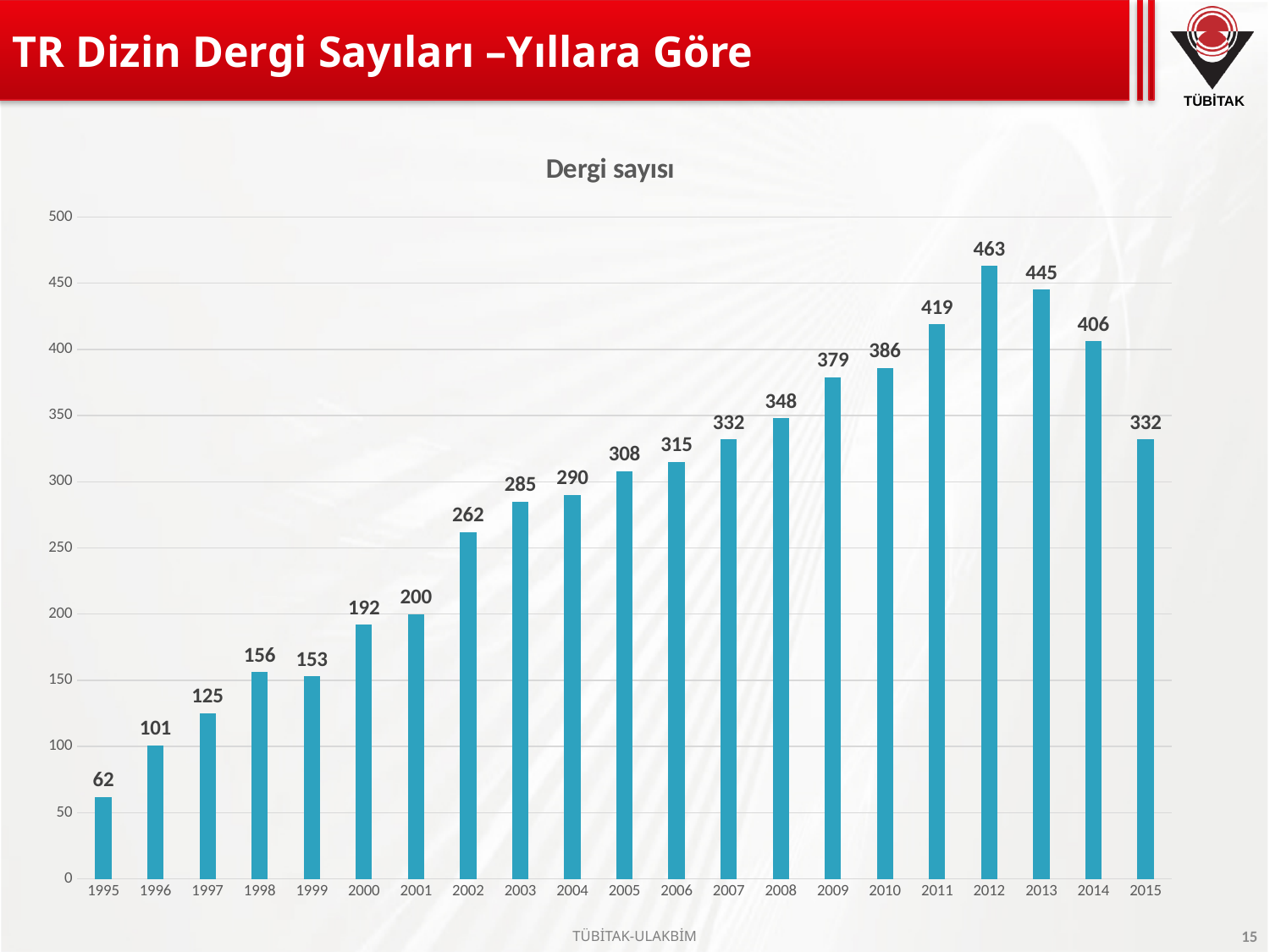
What is the value for 1995? 62 What is the difference between the values for 2012 and 2013? 18 Which year has the lowest value? 1995 What is the value for 2015? 332 Which is larger, the value for 1998 or the value for 1999? 1998 Is the value for 2009 greater or less than 350? greater What is the value for 2012? 463 What is the title of the chart? Dergi sayısı Which year has the highest value? 2012 How many years are shown on the x axis? 21 What is the difference between the values for 2014 and 2015? 74 What kind of chart is shown on the slide? bar chart